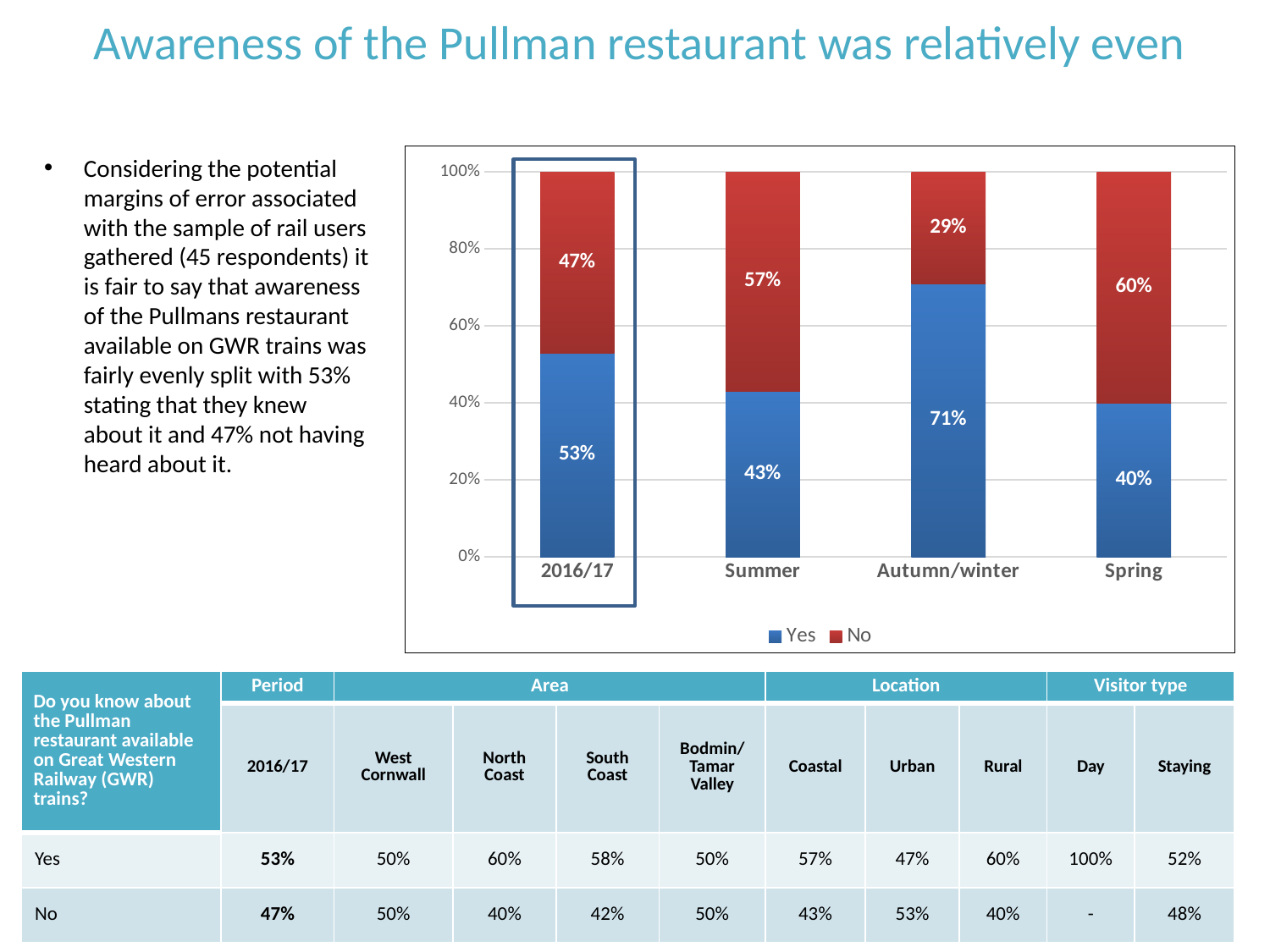
What is the 'Yes' value for 2016/17? 53% How many series does the legend list? 2 Which category has the highest 'Yes' value? Autumn/winter How many categories are shown on the x axis? 4 What is the difference between the 'Yes' values for Autumn/winter and Summer? 28% What is the 'No' value for Autumn/winter? 29% What is the total of the stacked bar for Summer? 100% Which is larger, the 'No' value for Summer or the 'No' value for Spring? Spring What kind of chart is shown? Stacked bar chart Which category has the lowest 'Yes' value? Spring What is the 'Yes' value for Summer? 43% What is the 'No' value for Spring? 60%